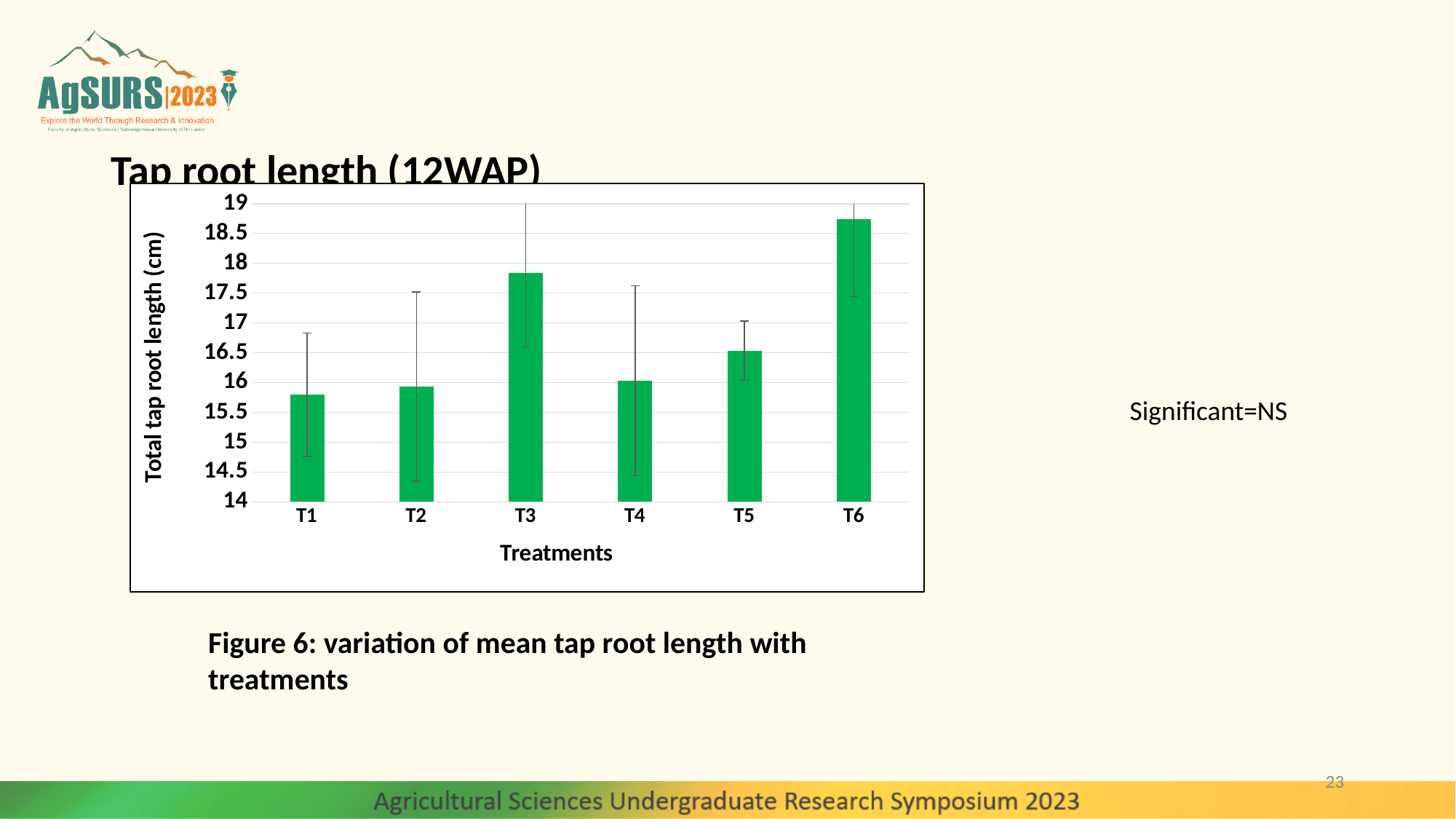
Is the value for T5 greater or less than 16? greater How many treatments are plotted on the x axis? 6 What kind of chart is shown on the slide? bar chart Is the value for T4 greater or less than 16.5? less Which treatment has the highest total tap root length? T6 Is the value for T3 greater or less than 17? greater Which has the larger total tap root length, T6 or T3? T6 Which has the larger total tap root length, T3 or T5? T3 What is the label of the y axis? Total tap root length (cm) What is the label of the x axis? Treatments